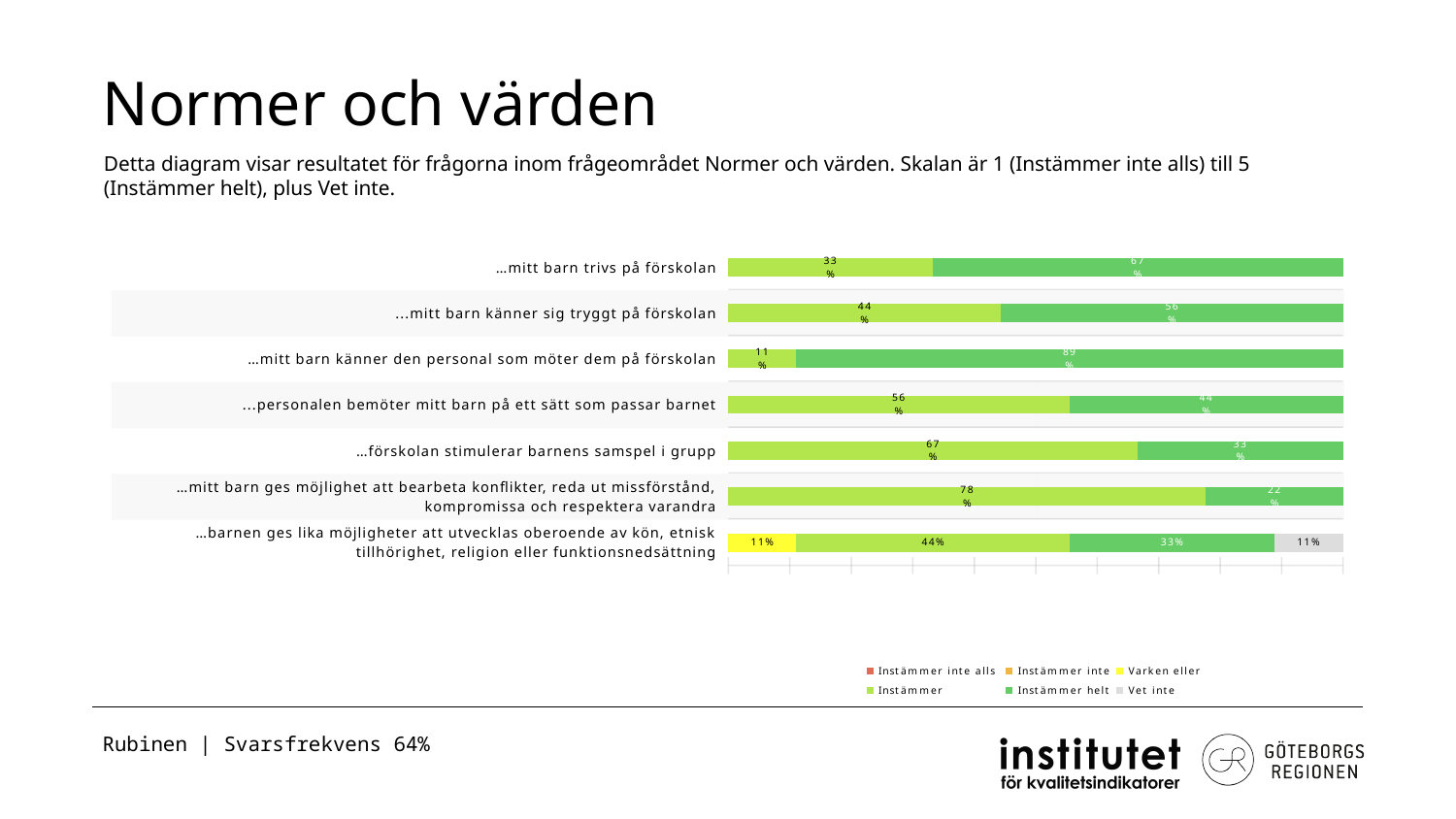
How many series does the legend list? 6 What is the title of the slide containing the chart? Normer och värden Which statement has the highest 'Instämmer helt' share? …mitt barn känner den personal som möter dem på förskolan Which statement has the highest 'Instämmer' share? …mitt barn ges möjlighet att bearbeta konflikter, reda ut missförstånd, kompromissa och respektera varandra What is the 'Instämmer helt' share for '…mitt barn trivs på förskolan'? 67% What is the difference between the 'Instämmer helt' and 'Instämmer' shares for '…mitt barn trivs på förskolan'? 34% For '…förskolan stimulerar barnens samspel i grupp', which is larger: the 'Instämmer' share or the 'Instämmer helt' share? Instämmer How many statements (categories) are plotted in the chart? 7 What is the 'Instämmer' share for '…mitt barn känner sig tryggt på förskolan'? 44% What kind of chart is shown on the slide? Stacked bar chart What is the 'Instämmer helt' share for '…mitt barn känner den personal som möter dem på förskolan'? 89% What is the 'Vet inte' share for '…barnen ges lika möjligheter att utvecklas oberoende av kön, etnisk tillhörighet, religion eller funktionsnedsättning'? 11%